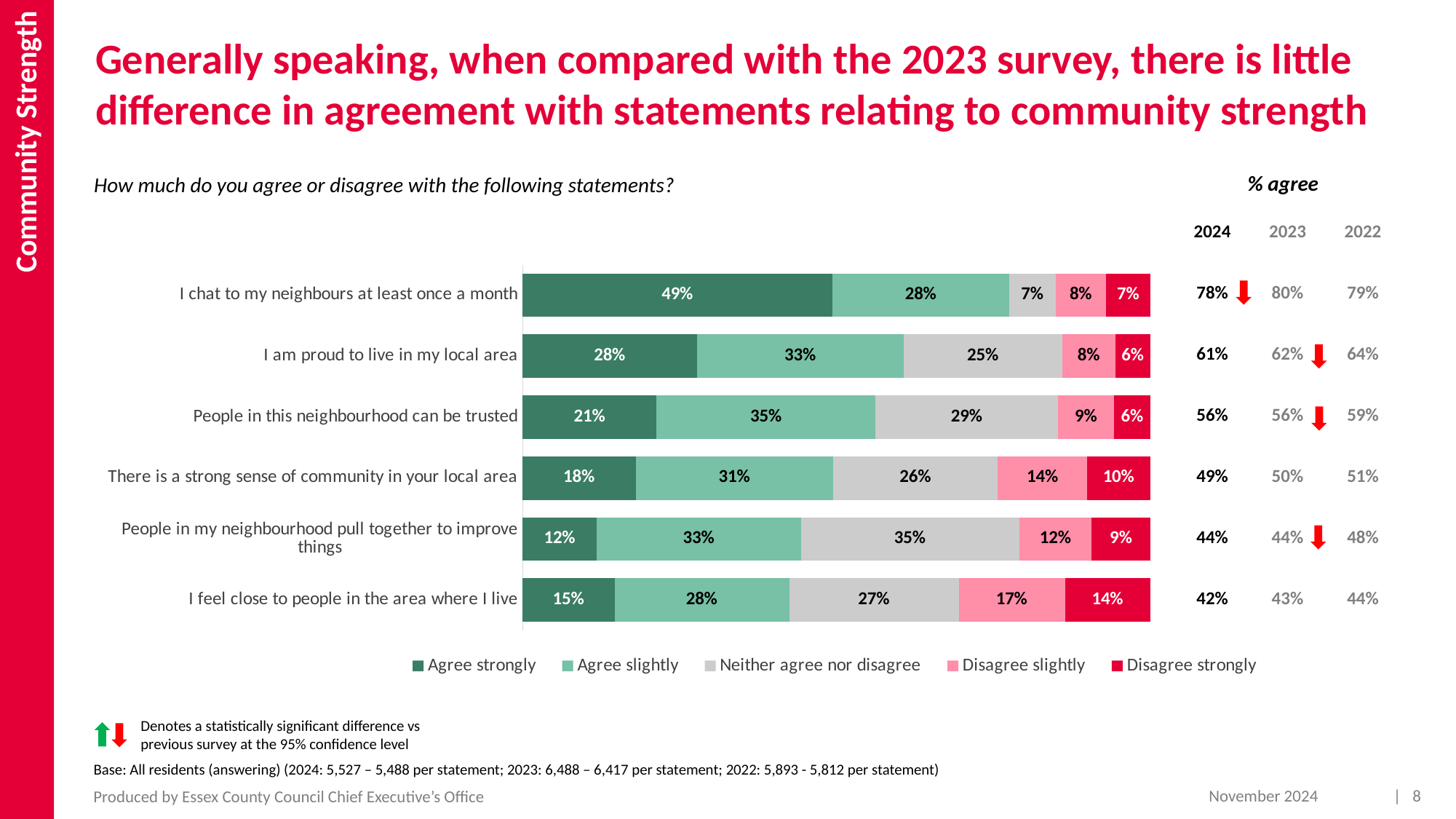
How many statements are shown in the chart? 6 Which statement has the highest "Agree strongly" value? I chat to my neighbours at least once a month How many percentage points higher is the "Agree slightly" value for "People in this neighbourhood can be trusted" than for "I chat to my neighbours at least once a month"? 7 percentage points What percentage disagree strongly with "I feel close to people in the area where I live"? 14% What percentage of respondents agree strongly with the statement "I chat to my neighbours at least once a month"? 49% What is the "Neither agree nor disagree" value for "People in my neighbourhood pull together to improve things"? 35% How many response categories does the legend list? 5 Which statement has the lowest "Agree strongly" value? People in my neighbourhood pull together to improve things What type of chart is used on this slide? Stacked bar chart What colour represents "Disagree strongly" in the chart? Red Which has the larger "Disagree slightly" value: "There is a strong sense of community in your local area" or "I feel close to people in the area where I live"? I feel close to people in the area where I live Which statement has the highest "Disagree strongly" value? I feel close to people in the area where I live